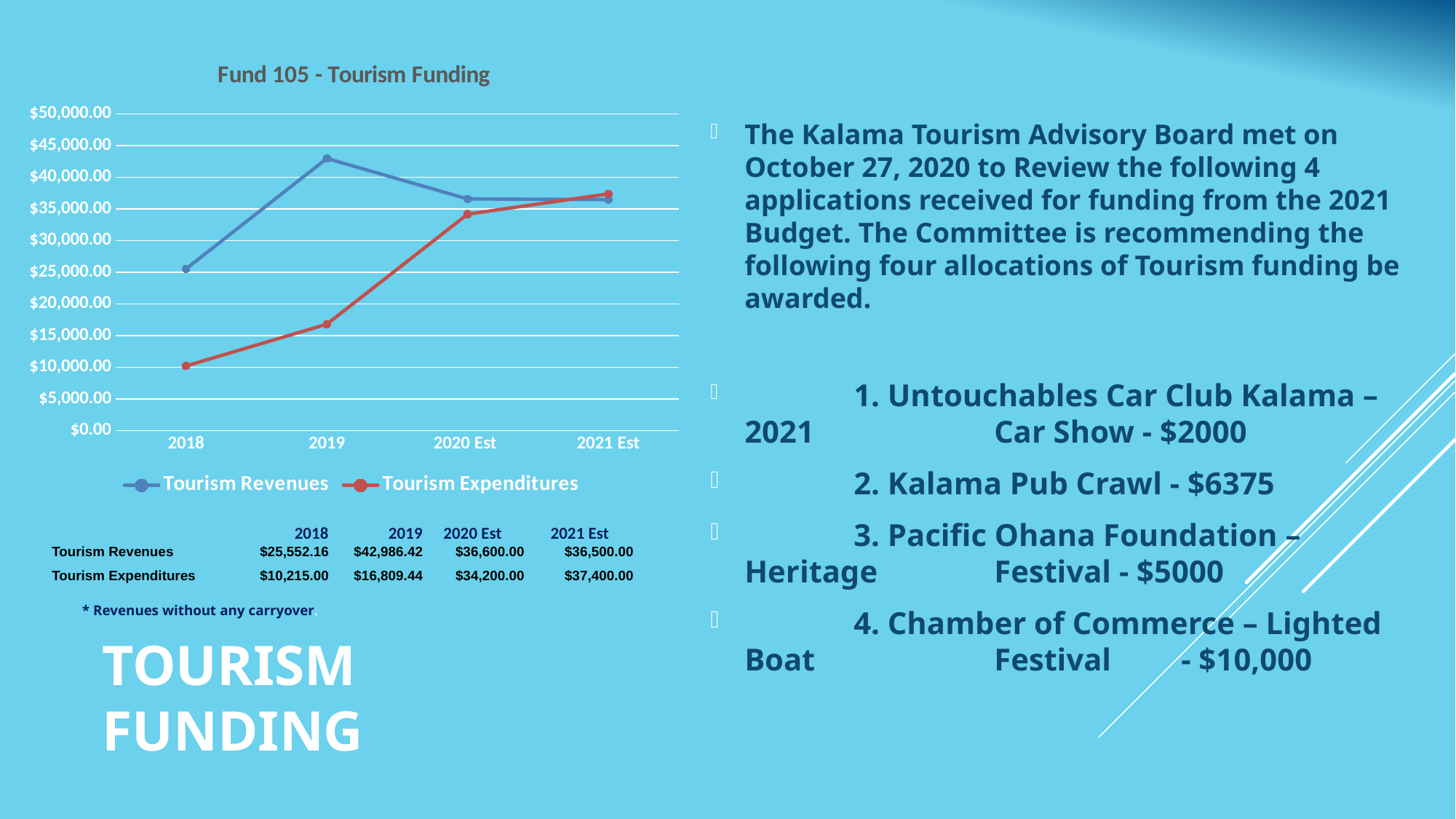
What colour is the Tourism Expenditures line in the chart? Red Which is larger for 2021 Est, Tourism Revenues or Tourism Expenditures? Tourism Expenditures How many series does the legend of the Fund 105 - Tourism Funding chart list? 2 What type of chart is shown under the title "Fund 105 - Tourism Funding"? Line chart How many time periods are plotted along the x axis of the Fund 105 - Tourism Funding chart? 4 What is the value of Tourism Expenditures for 2021 Est? $37,400.00 What is the value of Tourism Expenditures for 2018? $10,215.00 What is the value of Tourism Revenues for 2019? $42,986.42 Do Tourism Expenditures rise or fall from 2018 to 2021 Est? Rise In which year are Tourism Expenditures lowest? 2018 What is the difference between Tourism Revenues and Tourism Expenditures in 2018? $15,337.16 In which year are Tourism Revenues highest? 2019